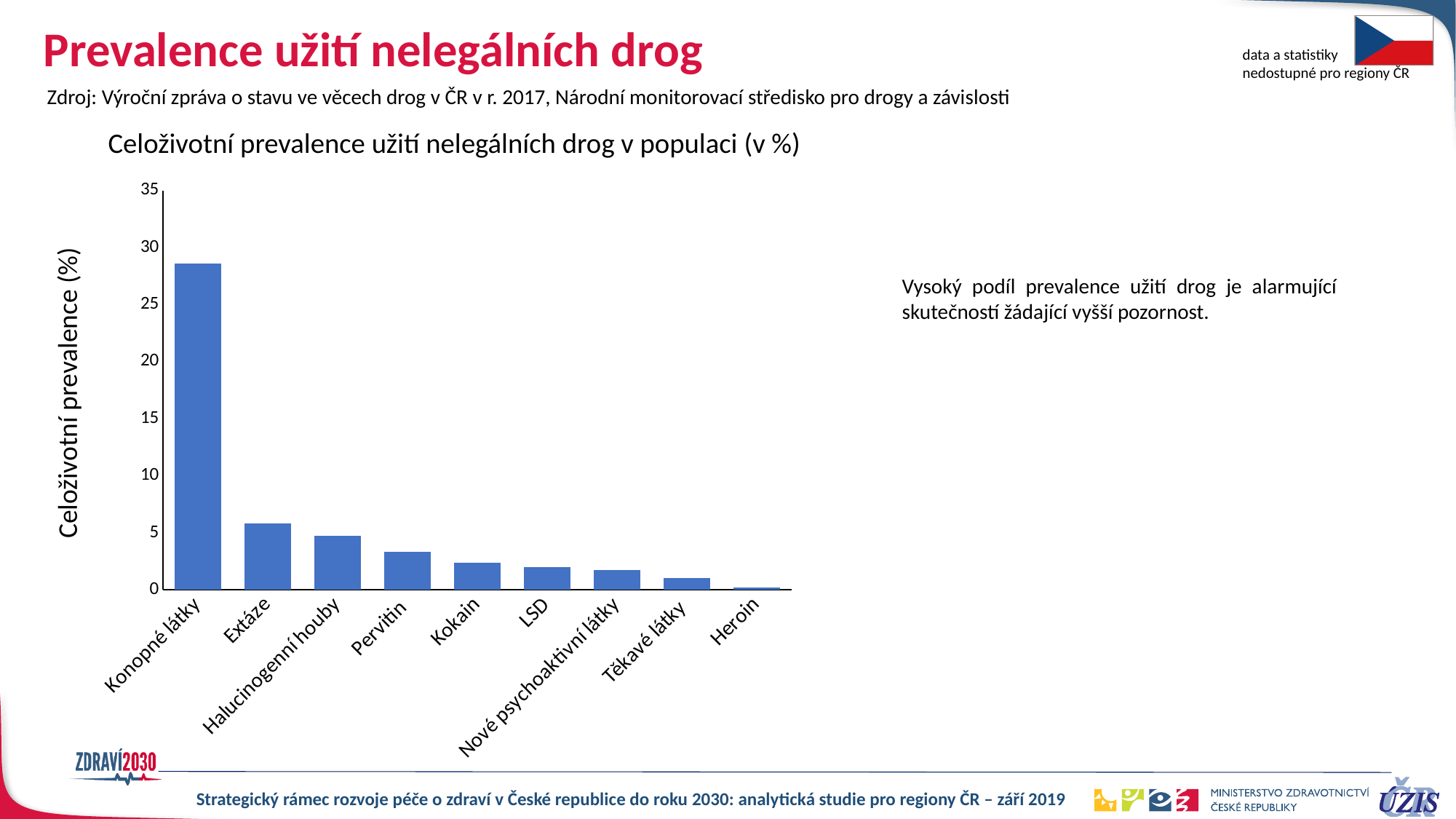
What is the title of the chart? Celoživotní prevalence užití nelegálních drog v populaci (v %) What is the label of the y axis? Celoživotní prevalence (%) Is the value for Extáze greater or less than 10? less Is the value for Konopné látky greater or less than 25? greater Which is larger, the value for Kokain or the value for Těkavé látky? Kokain Which category has the lowest lifetime prevalence in the chart? Heroin What kind of chart is shown on the slide? Bar chart How many categories are shown on the x axis of the chart? 9 Which is larger, the value for Extáze or the value for Pervitin? Extáze Which category has the highest lifetime prevalence in the chart? Konopné látky Do the values rise or fall moving from left to right along the x axis? Fall